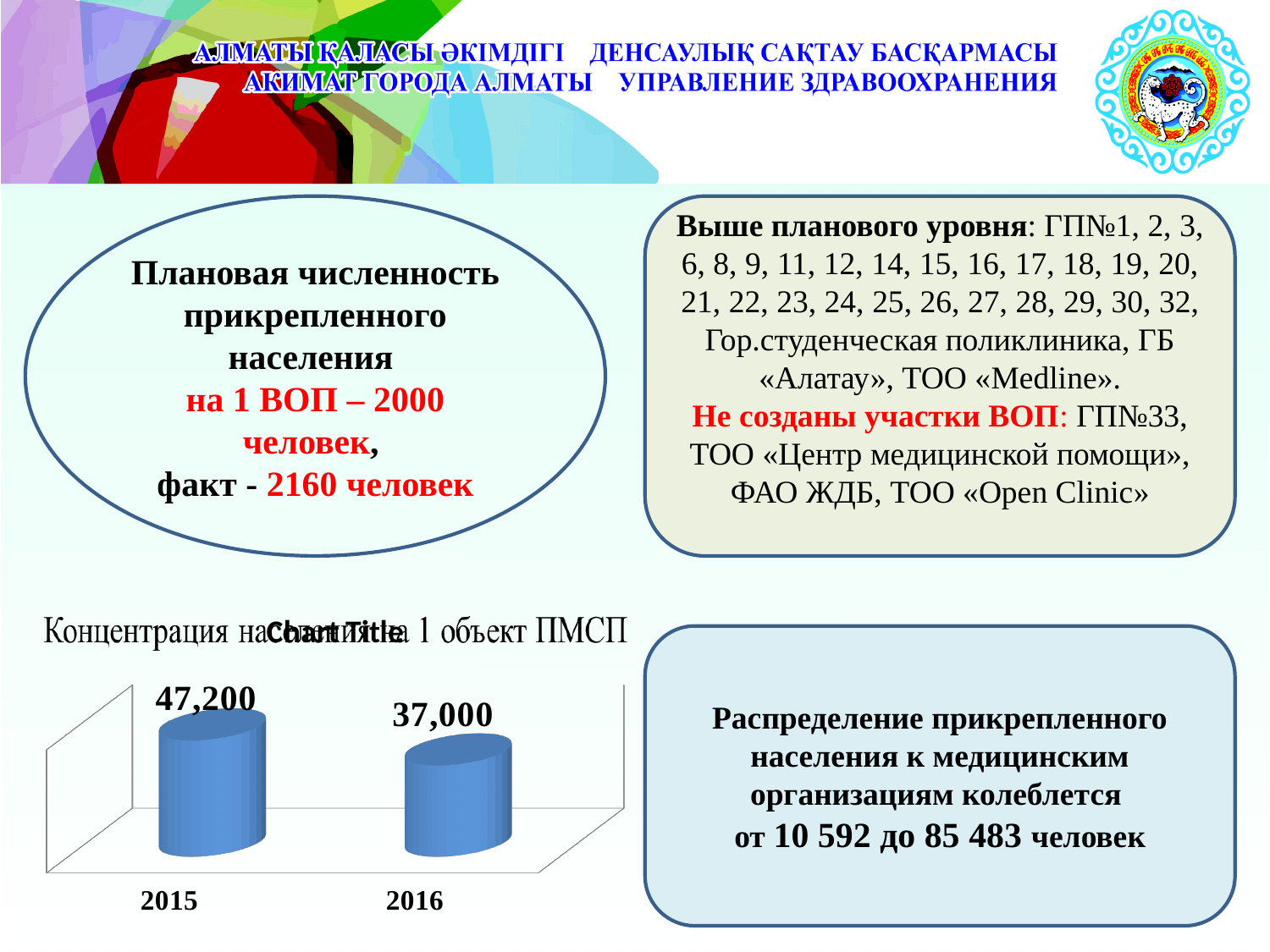
What is the difference between the 2015 and 2016 values in the chart? 10,200 Do the values in the chart rise or fall from 2015 to 2016? fall Which year has the highest value in the chart? 2015 Which is larger in the chart, the value for 2015 or the value for 2016? 2015 Which year has the lowest value in the chart? 2016 What is the value for 2016 in the chart? 37,000 How many categories are plotted in the chart? 2 What is the value for 2015 in the chart? 47,200 Which years are shown on the x axis of the chart? 2015 and 2016 What kind of chart is shown on the slide? bar chart What colour are the bars in the chart? blue